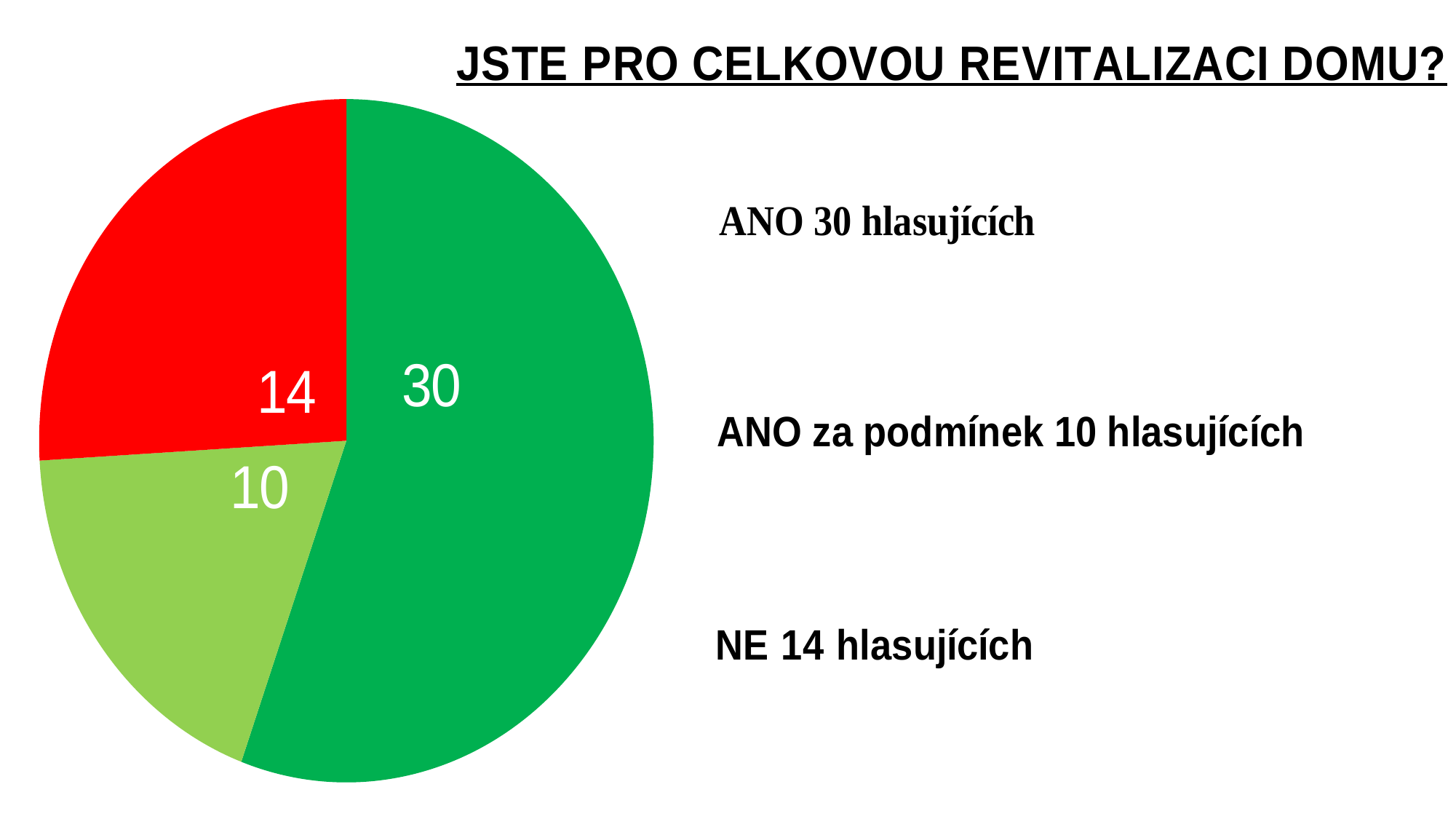
Which response received the most votes? ANO How many votes does the ANO slice represent? 30 How many votes does the NE slice represent? 14 What is the total number of votes shown in the pie chart? 54 Which response received the fewest votes? ANO za podmínek Which received more votes, NE or ANO za podmínek? NE How many slices does the pie chart have? 3 What is the difference between the ANO votes and the NE votes? 16 How many votes does the ANO za podmínek slice represent? 10 What type of chart is shown on the slide? pie chart What is the title of the slide? JSTE PRO CELKOVOU REVITALIZACI DOMU? What colour is the slice representing NE? red